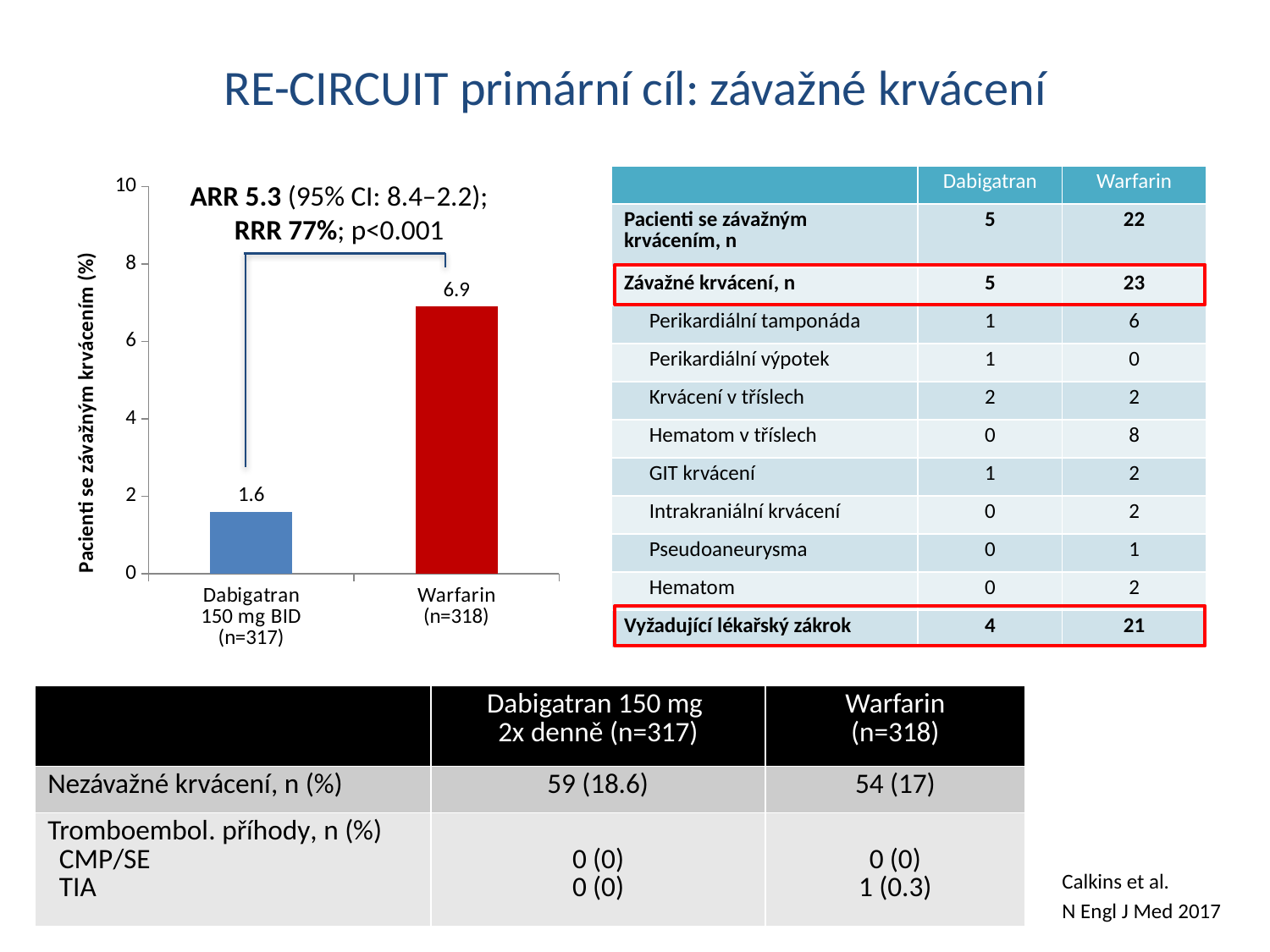
What is the value for Dabigatran 150 mg BID (n=317) in the bar chart? 1.6 What is the value for Warfarin (n=318) in the bar chart? 6.9 What is the y-axis label of the bar chart? Pacienti se závažným krvácením (%) Which group has the lower percentage of patients with major bleeding in the bar chart? Dabigatran 150 mg BID (n=317) Which group has the higher percentage of patients with major bleeding in the bar chart? Warfarin (n=318) What kind of chart is shown on the left of the slide? Bar chart How many bars are shown in the bar chart? 2 Is the value for Dabigatran in the bar chart greater or less than 2? less Is the value for Warfarin in the bar chart greater or less than 6? greater Is the Dabigatran bar larger or smaller than the Warfarin bar in the bar chart? smaller What is the maximum value shown on the y-axis of the bar chart? 10 What is the difference between the Warfarin and Dabigatran values in the bar chart? 5.3